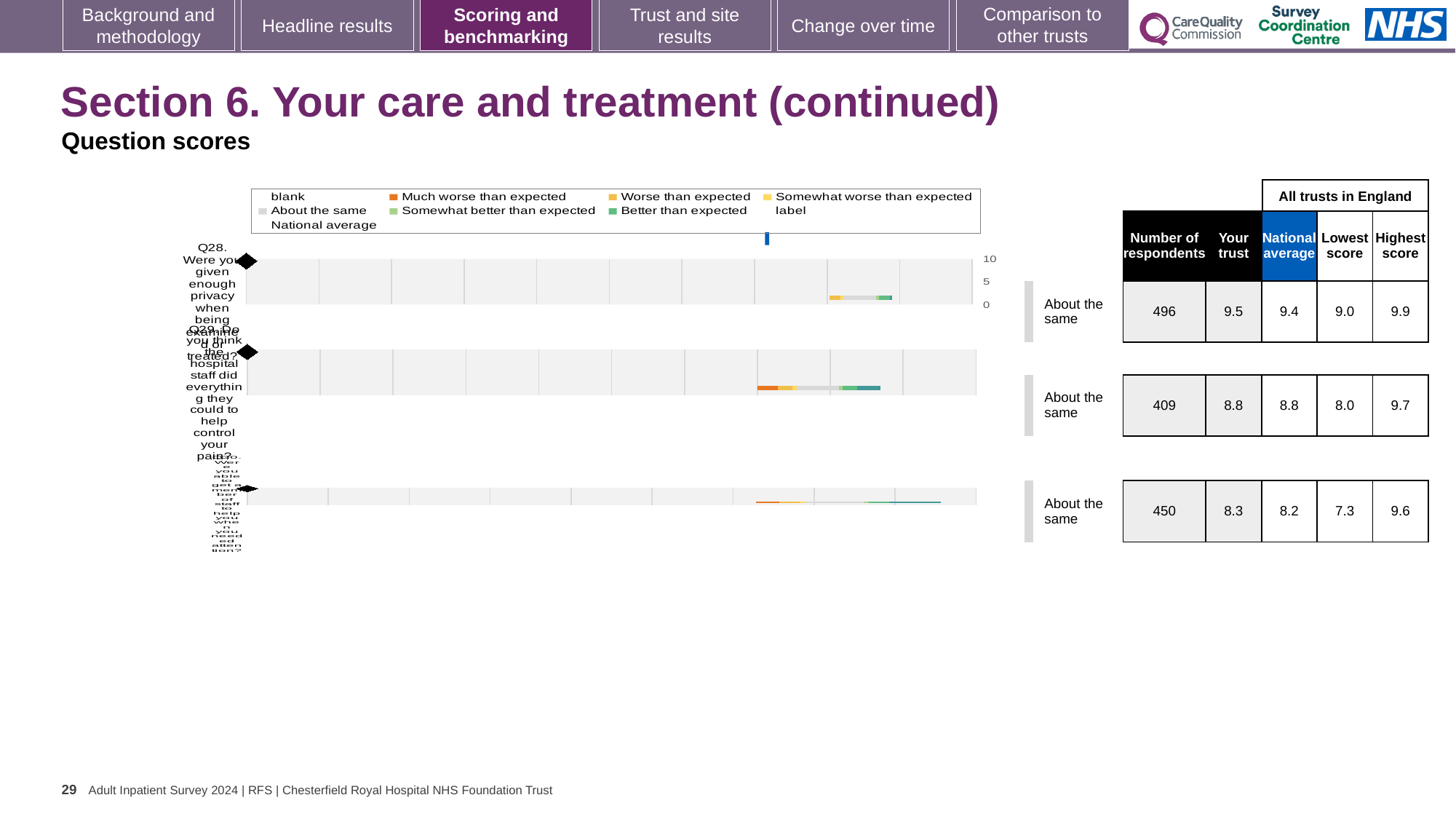
What is the 'Your trust' score for Q30 (Were you able to get a member of staff to help you when you needed attention?)? 8.3 How many questions (Q28, Q29, Q30) are plotted on the slide? 3 How many entries does the chart legend list? 9 Which of the three questions has the lowest 'Your trust' score? Q30 Which of the three questions has the highest 'Your trust' score? Q28 What is the 'Your trust' score for Q28 (Were you given enough privacy when being examined or treated?)? 9.5 How many respondents answered Q29? 409 What kind of chart is used to show the question scores on this slide? bar chart For Q30, is the 'Your trust' score (8.3) larger or smaller than the national average (8.2)? larger What is the national average score for Q29 (Do you think the hospital staff did everything they could to help control your pain?)? 8.8 What benchmark category is shown for all three questions on this slide? About the same What is the difference between the highest score (9.9) and the lowest score (9.0) across all trusts in England for Q28? 0.9